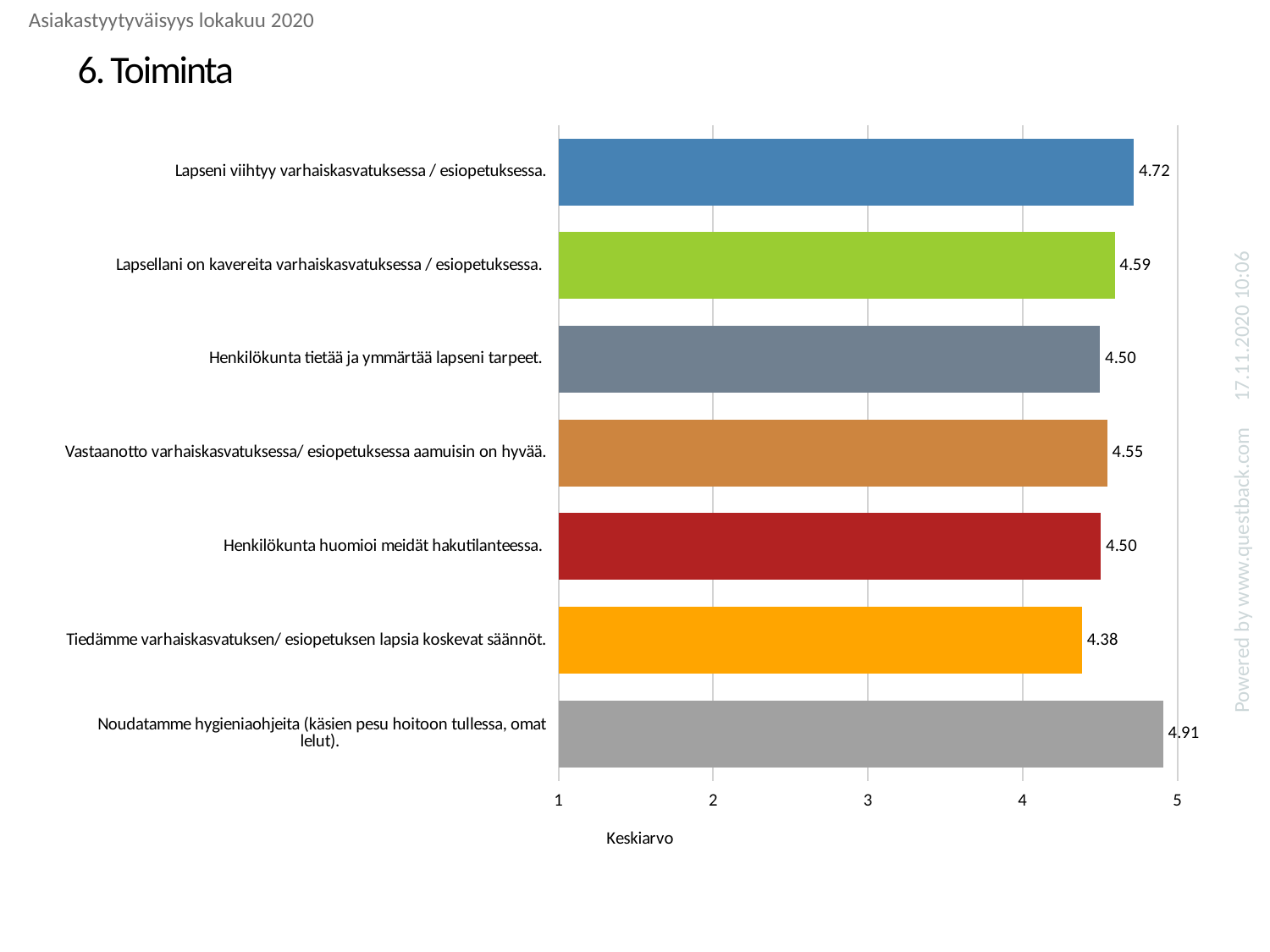
Is the value for "Henkilökunta huomioi meidät hakutilanteessa." greater or less than 4? greater What is the value for "Lapseni viihtyy varhaiskasvatuksessa / esiopetuksessa."? 4.72 Which category has the lowest value? Tiedämme varhaiskasvatuksen/ esiopetuksen lapsia koskevat säännöt. What is the value for "Vastaanotto varhaiskasvatuksessa/ esiopetuksessa aamuisin on hyvää."? 4.55 What is the label of the horizontal axis? Keskiarvo What is the value for "Tiedämme varhaiskasvatuksen/ esiopetuksen lapsia koskevat säännöt."? 4.38 Which is larger: the value for "Lapsellani on kavereita varhaiskasvatuksessa / esiopetuksessa." or the value for "Henkilökunta tietää ja ymmärtää lapseni tarpeet."? Lapsellani on kavereita varhaiskasvatuksessa / esiopetuksessa. What is the difference between the values for "Noudatamme hygieniaohjeita (käsien pesu hoitoon tullessa, omat lelut)." and "Tiedämme varhaiskasvatuksen/ esiopetuksen lapsia koskevat säännöt."? 0.53 What is the difference between the values for "Lapseni viihtyy varhaiskasvatuksessa / esiopetuksessa." and "Lapsellani on kavereita varhaiskasvatuksessa / esiopetuksessa."? 0.13 What kind of chart is shown on the slide? bar chart How many categories are shown in the chart? 7 Which category has the highest value? Noudatamme hygieniaohjeita (käsien pesu hoitoon tullessa, omat lelut).